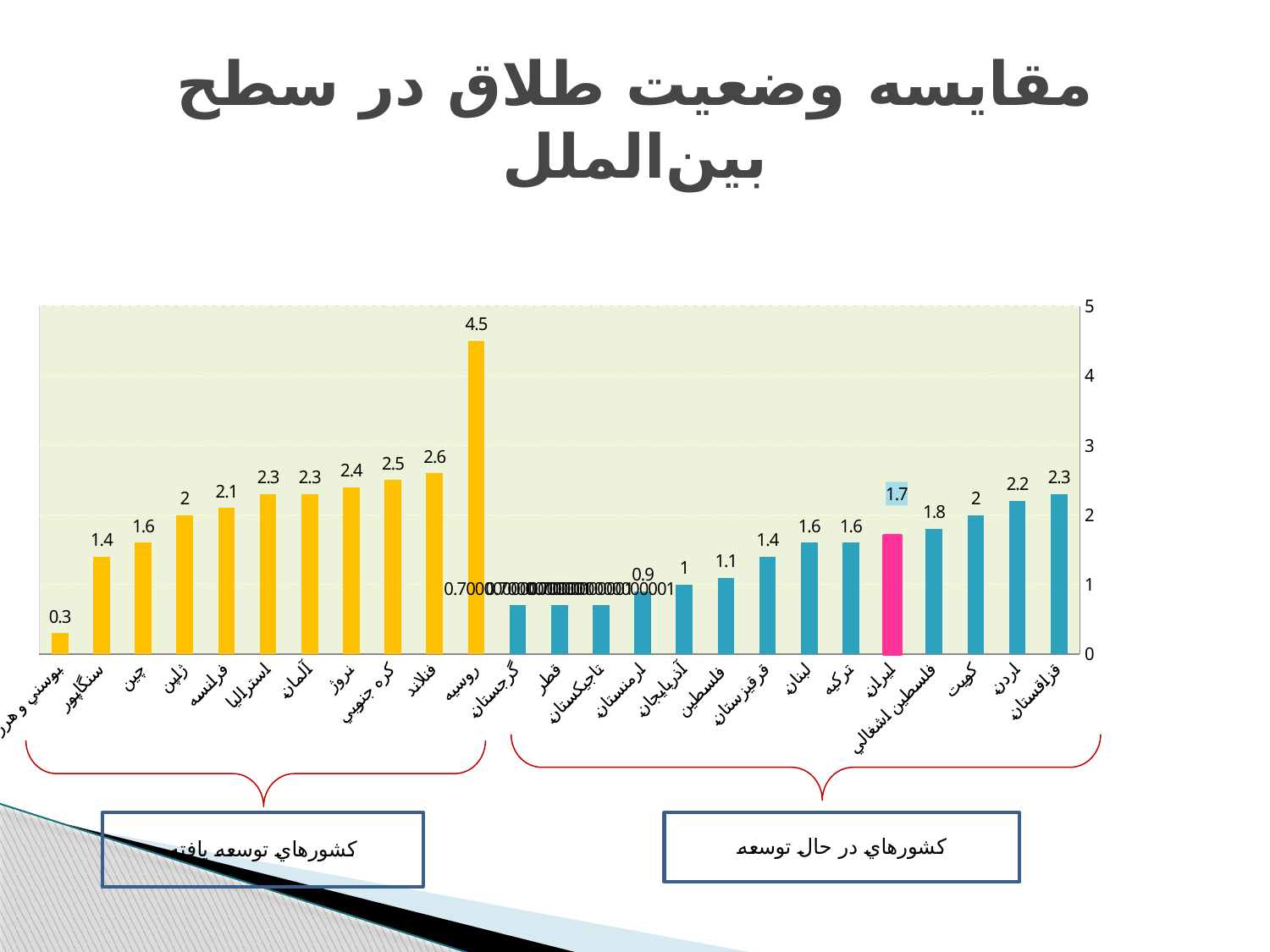
What is the difference between the values for روسیه (Russia) and فنلاند (Finland)? 1.9 Which is larger, the value for اردن (Jordan) or the value for کویت (Kuwait)? اردن (Jordan) Is the value for ارمنستان (Armenia) greater or less than 1? less What colour is the bar for ایران (Iran)? pink What is the value for قزاقستان (Kazakhstan)? 2.3 What type of chart is shown on the slide? bar chart What is the value for ایران (Iran), the pink bar? 1.7 Which country has the highest value in the chart? روسیه (Russia) Which country has the lowest value in the chart? بوسنی و هرزگوین (Bosnia and Herzegovina) What is the value for فنلاند (Finland)? 2.6 How many countries (bars) are shown in the chart? 25 What is the value for روسیه (Russia)? 4.5